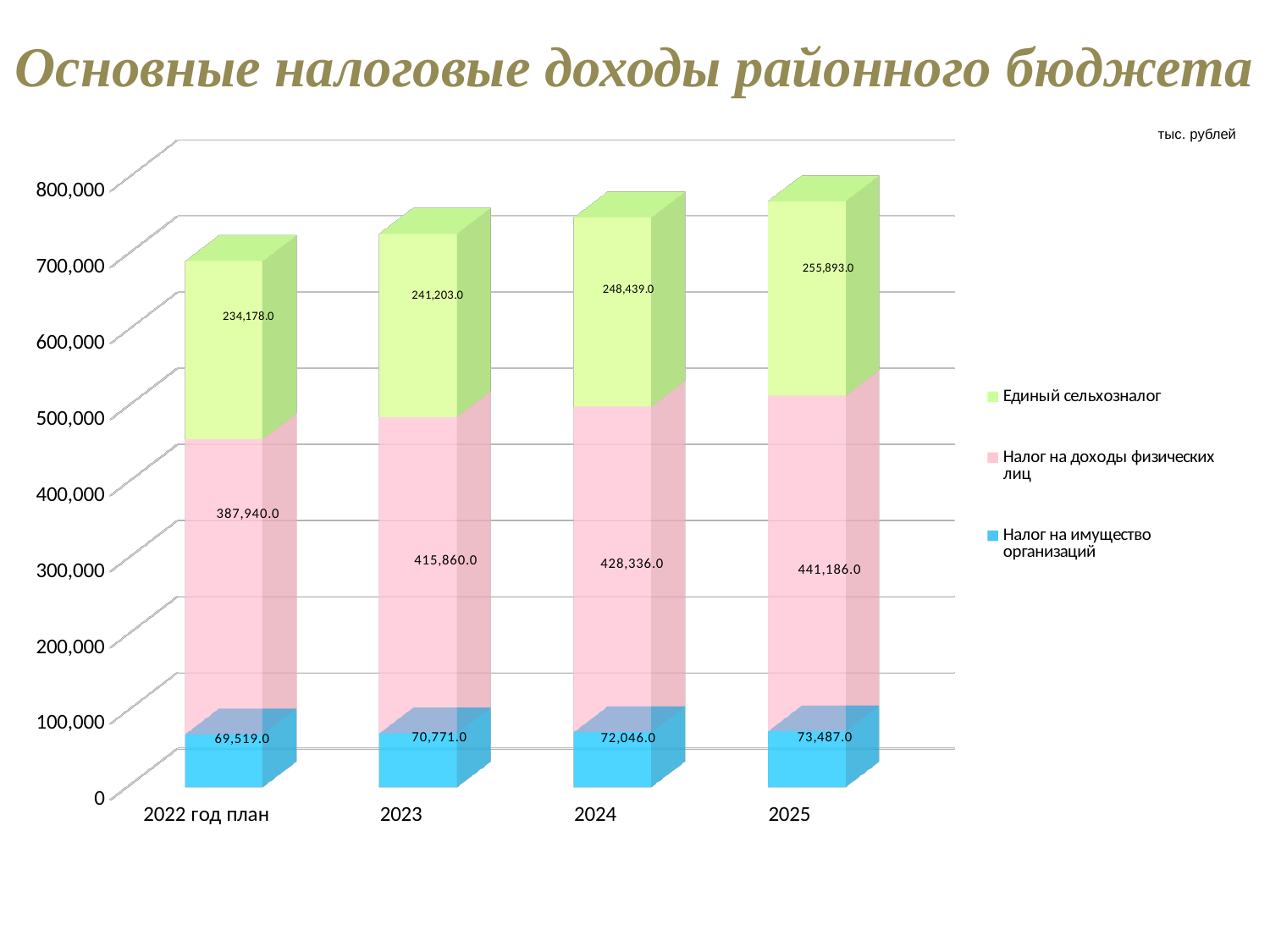
What kind of chart is shown on the slide? Stacked bar chart Do the values of Налог на имущество организаций rise or fall from 2022 год план to 2025? Rise How many categories are shown on the x axis? 4 What is the value of Налог на доходы физических лиц for 2023? 415,860.0 In which category is Единый сельхозналог the lowest? 2022 год план What is the total of the stacked bar for 2023? 727,834.0 What is the difference between Налог на доходы физических лиц in 2025 and in 2022 год план? 53,246.0 How many series does the legend list? 3 Which is larger: Единый сельхозналог in 2024 or Налог на имущество организаций in 2024? Единый сельхозналог in 2024 What is the value of Единый сельхозналог for 2025? 255,893.0 What is the value of Налог на имущество организаций for 2022 год план? 69,519.0 In which year is Налог на доходы физических лиц the highest? 2025